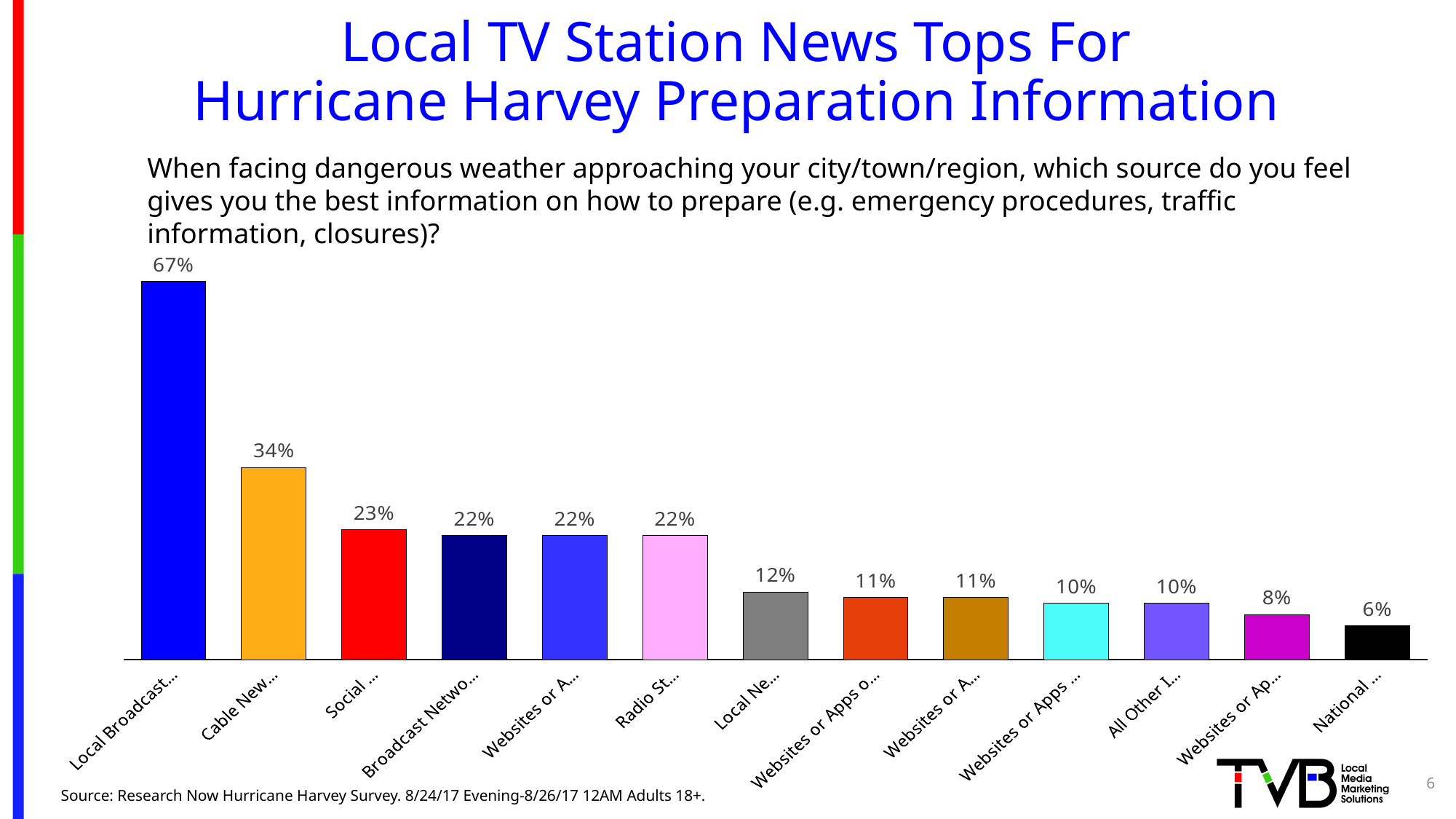
What is the value for the first bar, labelled "Local Broadcast..."? 67% What is the value for the bar labelled "Cable New..."? 34% Which is larger, the value for "Social ..." or the value for "Local Ne..."? Social ... What is the title of the slide? Local TV Station News Tops For Hurricane Harvey Preparation Information Which category has the highest value? Local Broadcast... What is the value for the bar labelled "All Other I..."? 10% What is the value for the bar labelled "Radio St..."? 22% Do the values rise or fall from left to right across the chart? Fall Which category has the lowest value? National ... What is the difference between the values for "Local Broadcast..." and "Cable New..."? 33% How many bars are shown in the chart? 13 What kind of chart is shown on the slide? Bar chart